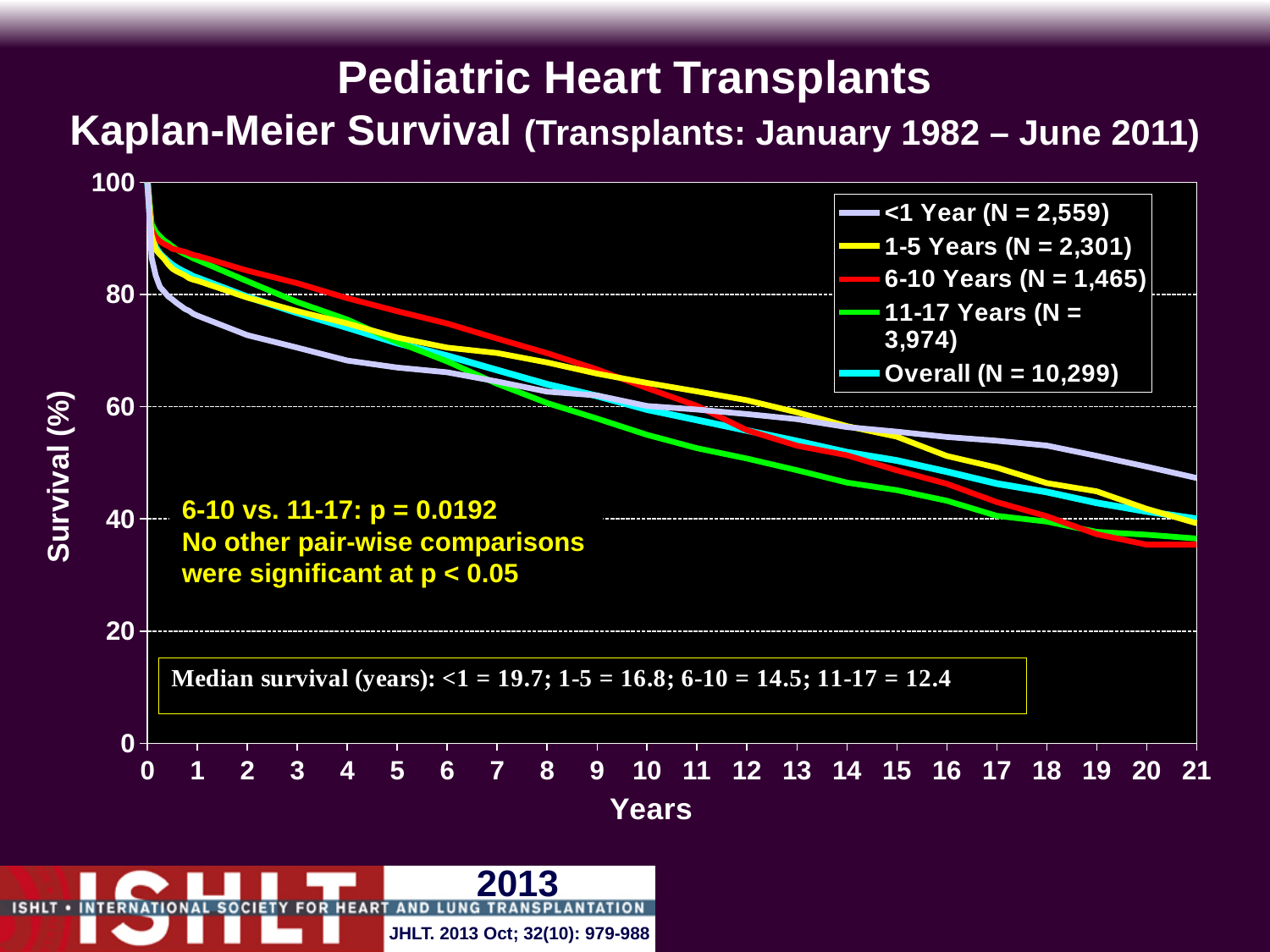
What is the N for the Overall group shown in the legend? 10,299 Which age group has the highest median survival? <1 Year At 20 years, which curve is higher: <1 Year or 6-10 Years? <1 Year How many series does the legend list? 5 Is the survival value for the <1 Year group at 20 years greater or less than 40? greater What is the median survival in years for the 11-17 Years group? 12.4 Which age group has the largest N in the legend? 11-17 Years What is the median survival in years for the 1-5 Years group? 16.8 Do the survival curves rise or fall as years increase? fall What is the difference in median survival (years) between the <1 Year group and the 11-17 Years group? 7.3 What is the N for the <1 Year group shown in the legend? 2,559 What kind of chart is shown on the slide? line chart